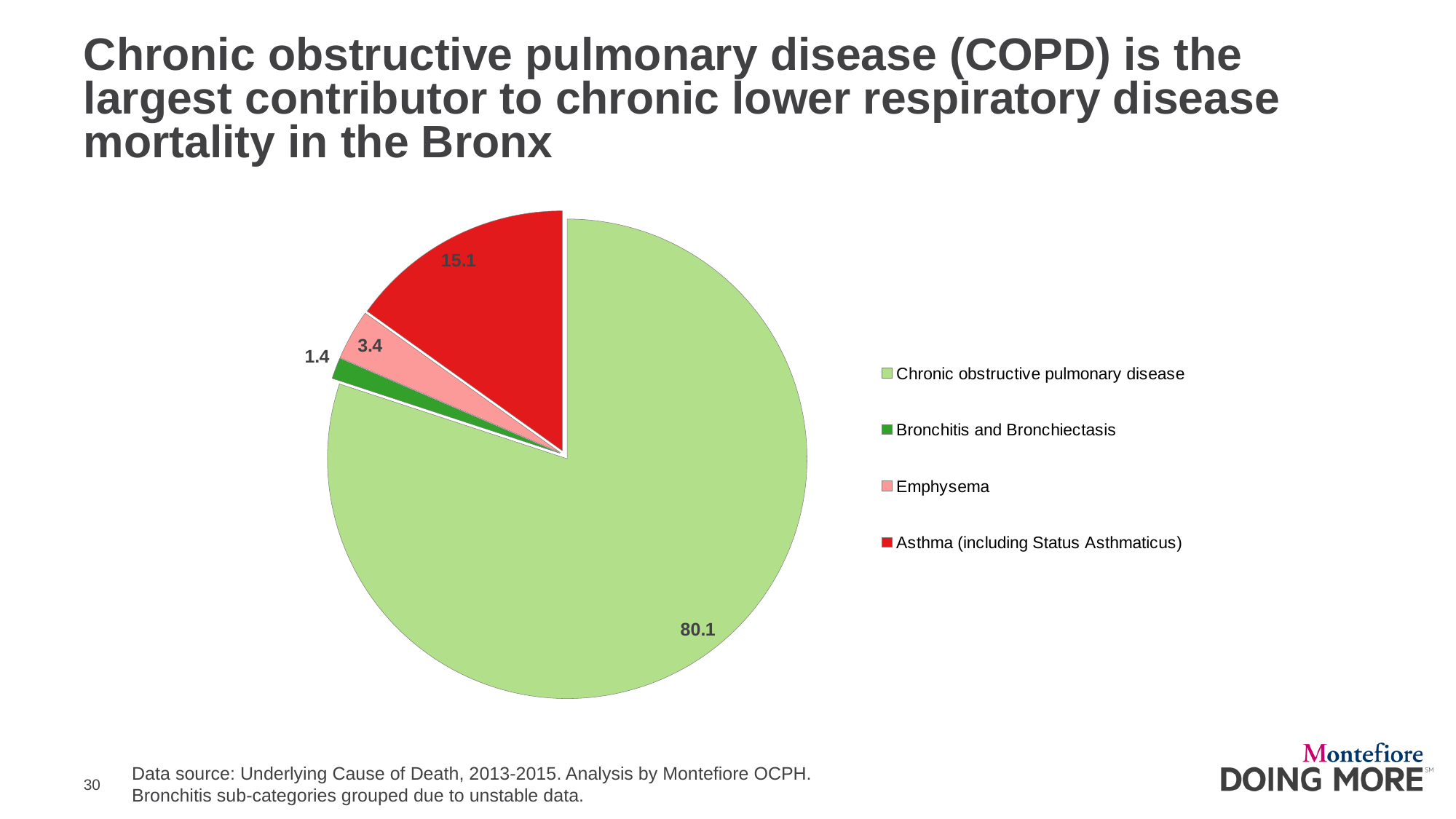
What is the difference between the values for Asthma (including Status Asthmaticus) and Emphysema? 11.7 What is the value shown for Emphysema? 3.4 Which category has the largest slice of the pie? Chronic obstructive pulmonary disease What is the value shown for Chronic obstructive pulmonary disease? 80.1 How many entries does the legend list? 4 What kind of chart is shown on the slide? pie chart What colour is the slice for Asthma (including Status Asthmaticus)? red Which category has the smallest slice of the pie? Bronchitis and Bronchiectasis Which is larger, the value for Emphysema or the value for Bronchitis and Bronchiectasis? Emphysema How many slices does the pie chart have? 4 What is the value shown for Asthma (including Status Asthmaticus)? 15.1 What is the value shown for Bronchitis and Bronchiectasis? 1.4